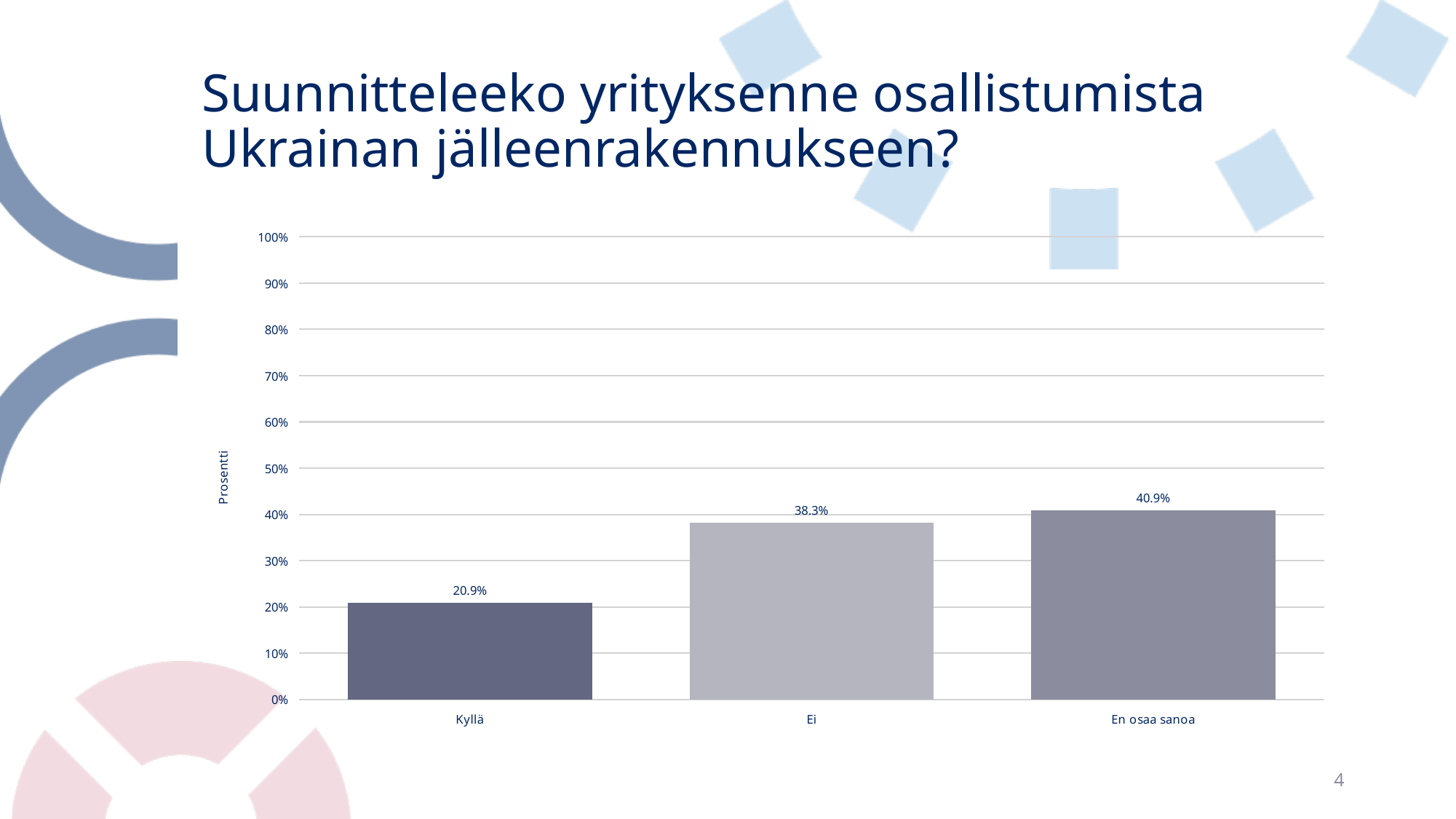
Which category has the lowest value? Kyllä Is the value for Kyllä greater or less than 30%? less Which is larger, the value for Kyllä or the value for Ei? Ei How many categories are shown on the x axis? 3 What kind of chart is shown on the slide? bar chart What is the difference between the values for Ei and Kyllä? 17.4% What is the value for Ei? 38.3% What is the value for En osaa sanoa? 40.9% What is the difference between the values for En osaa sanoa and Ei? 2.6% What is the value for Kyllä? 20.9% What is the label of the y axis? Prosentti Which category has the highest value? En osaa sanoa